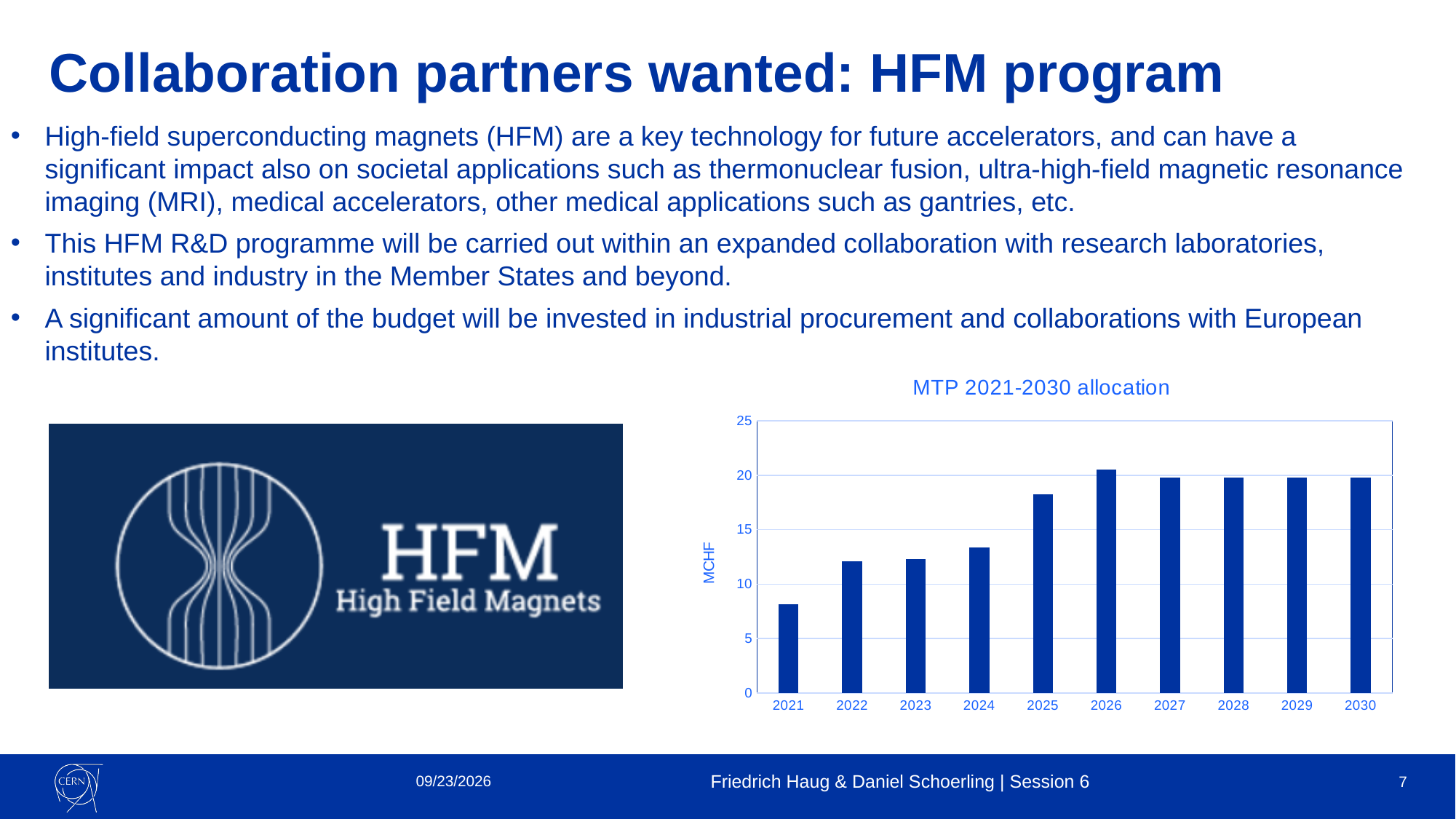
What is the title of the chart? MTP 2021-2030 allocation Do the values rise or fall from 2021 to 2026? rise Is the value for 2026 greater or less than 20? greater How many years are shown on the x axis of the chart? 10 Which year has the highest allocation in the chart? 2026 What is the label on the vertical axis of the chart? MCHF Which year has the larger allocation, 2024 or 2025? 2025 What kind of chart is shown on the slide? bar chart Is the value for 2021 greater or less than 10? less Which year has the lowest allocation in the chart? 2021 Is the value for 2024 greater or less than 15? less